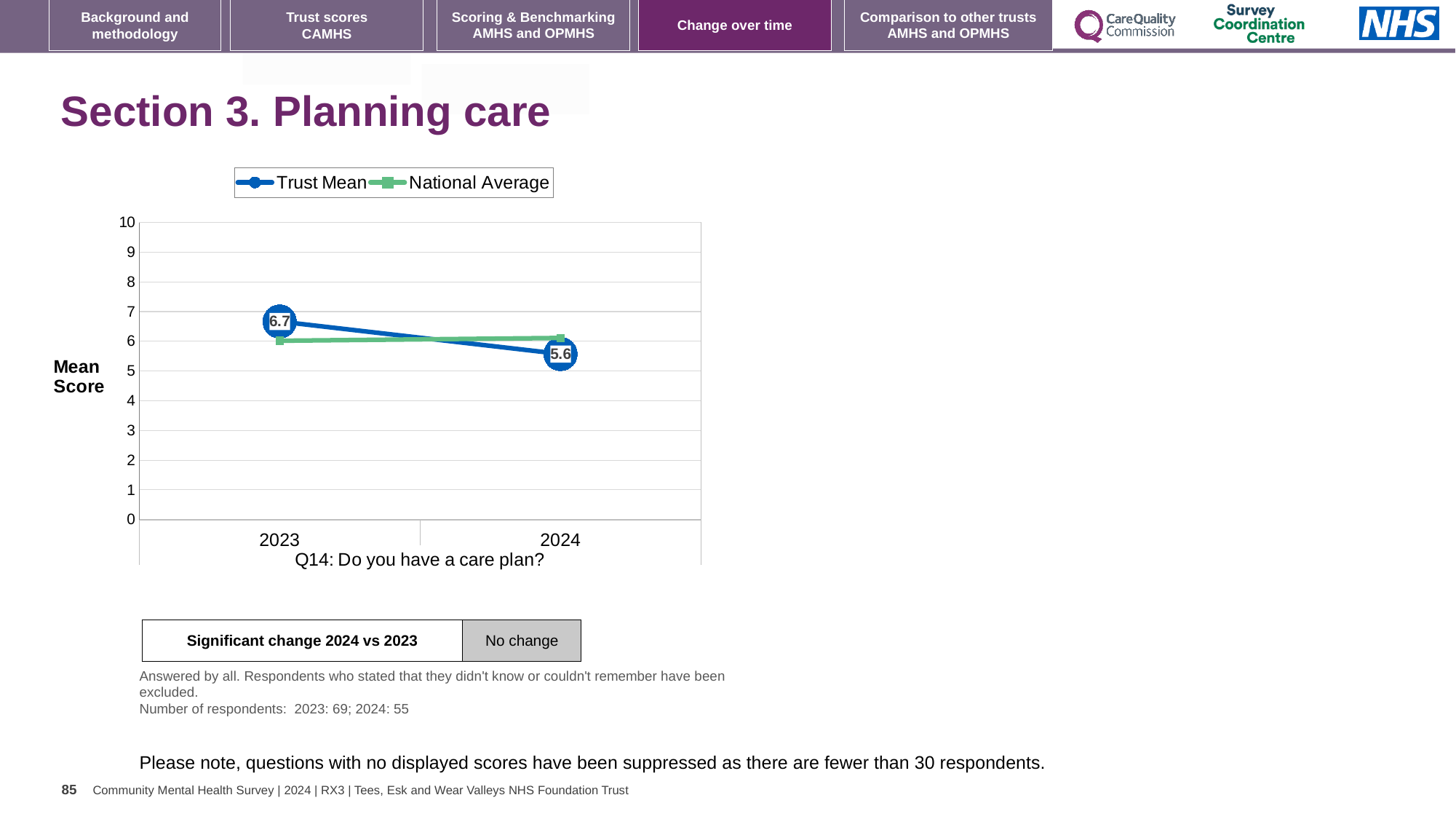
How many series does the legend list? 2 What is the Trust Mean value for 2024? 5.6 Is the National Average value for 2023 greater or less than 7? less What is the Trust Mean value for 2023? 6.7 Is the National Average value for 2024 greater or less than 5? greater Does the Trust Mean rise or fall from 2023 to 2024? fall What kind of chart is shown on the slide? line chart How many years are plotted on the x axis? 2 By how much did the Trust Mean change from 2023 to 2024? 1.1 Which year has the higher Trust Mean, 2023 or 2024? 2023 What survey question is the chart about, as labelled below the x axis? Q14: Do you have a care plan? In 2023, which is higher: the Trust Mean or the National Average? Trust Mean